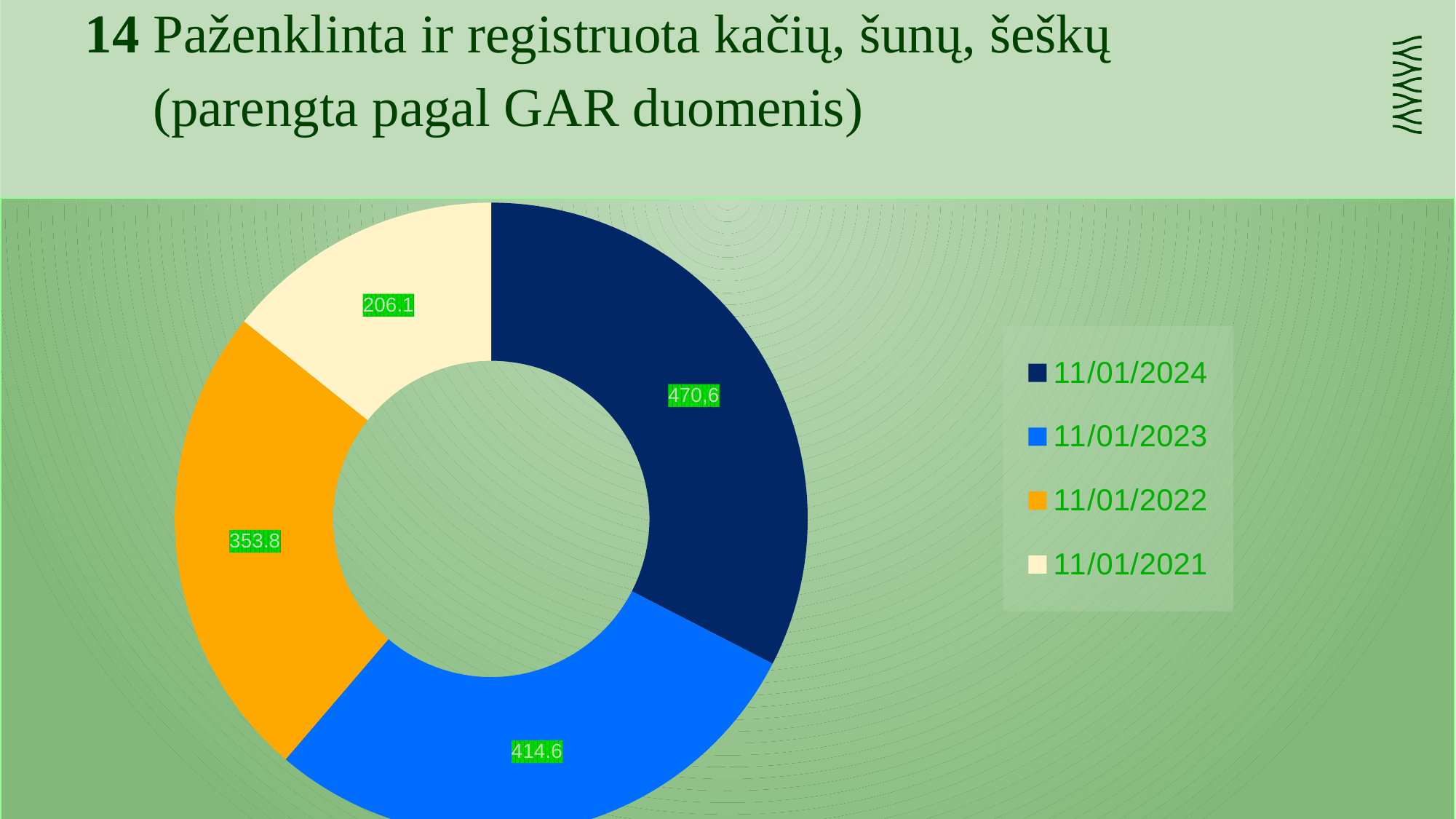
What is the difference between the values for 11/01/2023 and 11/01/2022? 60.8 What is the value for 11/01/2021 in the doughnut chart? 206.1 How many slices does the doughnut chart have? 4 What type of chart is shown on the slide? Doughnut chart What is the difference between the values for 11/01/2022 and 11/01/2021? 147.7 Which date has the largest slice in the chart? 11/01/2024 Which is larger, the value for 11/01/2023 or the value for 11/01/2021? 11/01/2023 Which colour represents 11/01/2022 in the legend? Orange What is the value for 11/01/2022 in the doughnut chart? 353.8 Which date has the smallest slice in the chart? 11/01/2021 What is the value for 11/01/2024 in the doughnut chart? 470,6 What is the value for 11/01/2023 in the doughnut chart? 414.6